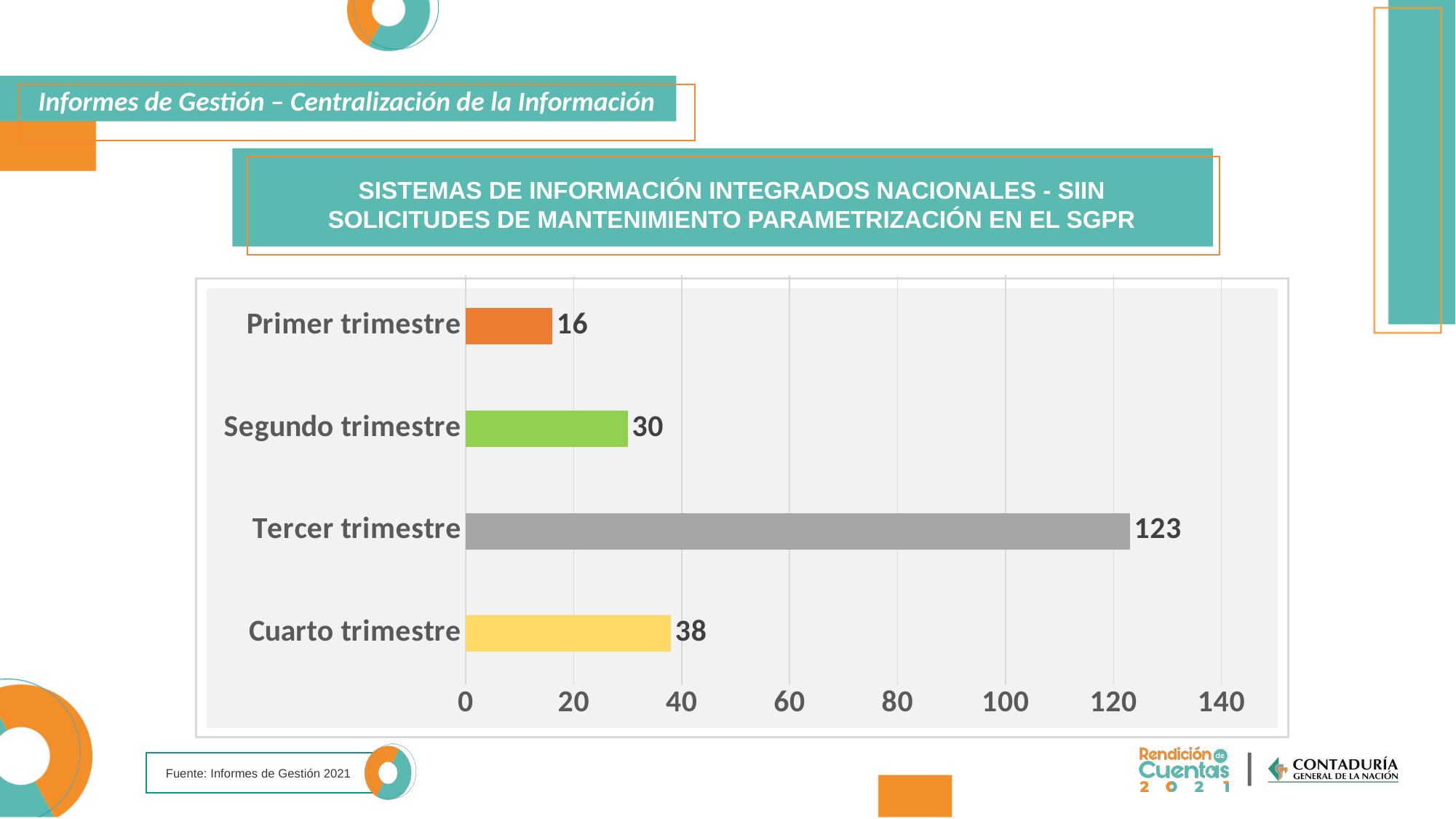
Which is larger, the value for Segundo trimestre or the value for Cuarto trimestre? Cuarto trimestre How many categories are shown in the chart? 4 What kind of chart is shown on the slide? bar chart What is the maximum value shown on the horizontal axis? 140 What is the value for Primer trimestre? 16 Is the value for Tercer trimestre greater or less than 100? greater Which quarter has the highest value? Tercer trimestre What is the value for Tercer trimestre? 123 What is the difference between the values for Tercer trimestre and Cuarto trimestre? 85 Which quarter has the lowest value? Primer trimestre What is the value for Cuarto trimestre? 38 What is the difference between the values for Segundo trimestre and Primer trimestre? 14